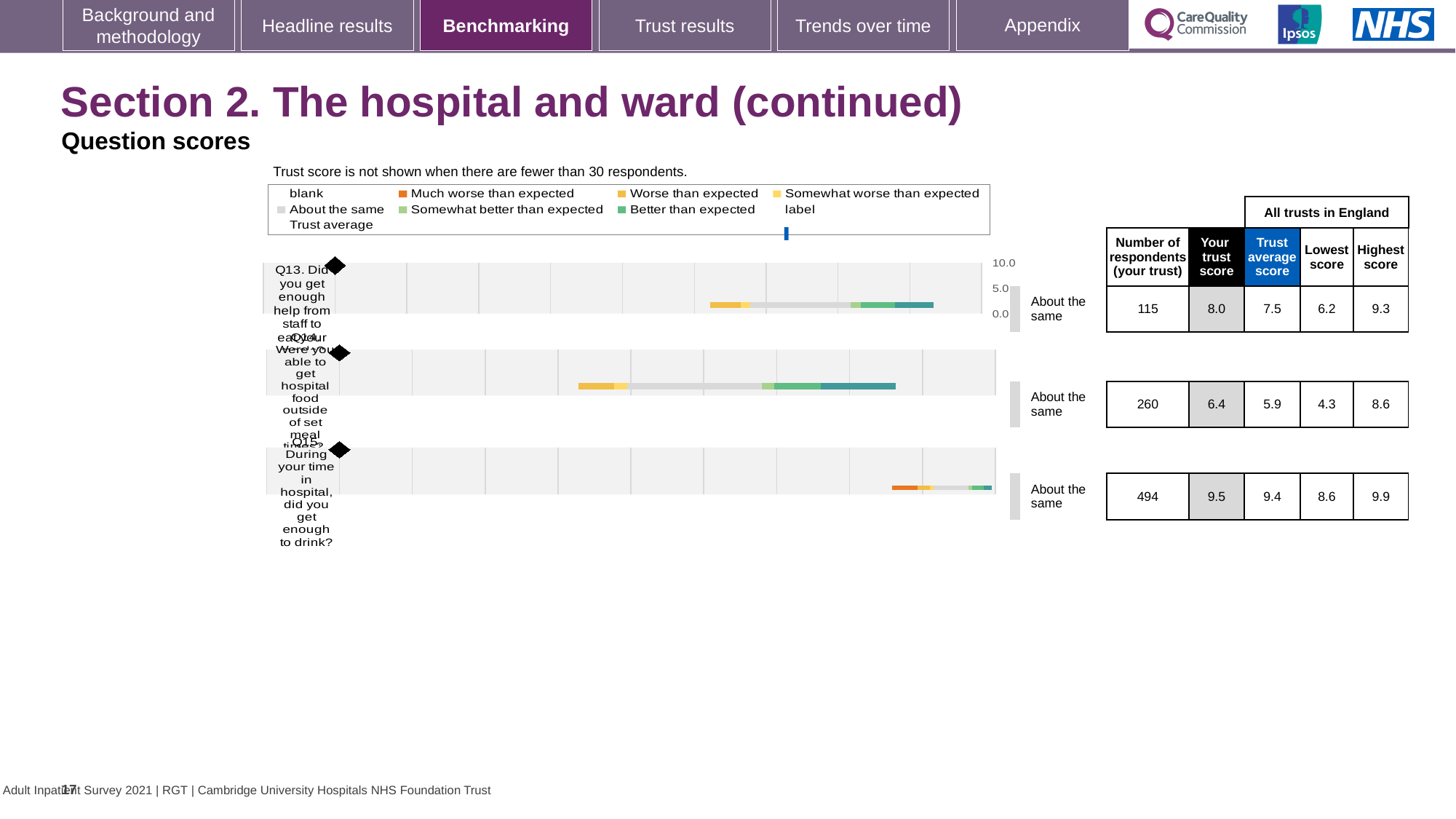
What is the 'Your trust score' for Q13 (Did you get enough help from staff to eat your meals?)? 8.0 How many questions (bars) are plotted in the chart? 3 What benchmark category is shown next to the bar for Q15? About the same Which question has the highest 'Your trust score'? Q15 According to the note above the chart, when is the trust score not shown? When there are fewer than 30 respondents Which question has the lowest number of respondents (your trust)? Q13 What is the trust average score for Q15 (During your time in hospital, did you get enough to drink?)? 9.4 What is the number of respondents (your trust) for Q14 (Were you able to get hospital food outside of set meal times?)? 260 What is the highest score across all trusts in England for Q14? 8.6 What kind of chart is used to show the question scores on this slide? bar chart What is the difference between the highest score and the lowest score for Q13? 3.1 Which is larger for Q14: your trust score or the trust average score? Your trust score